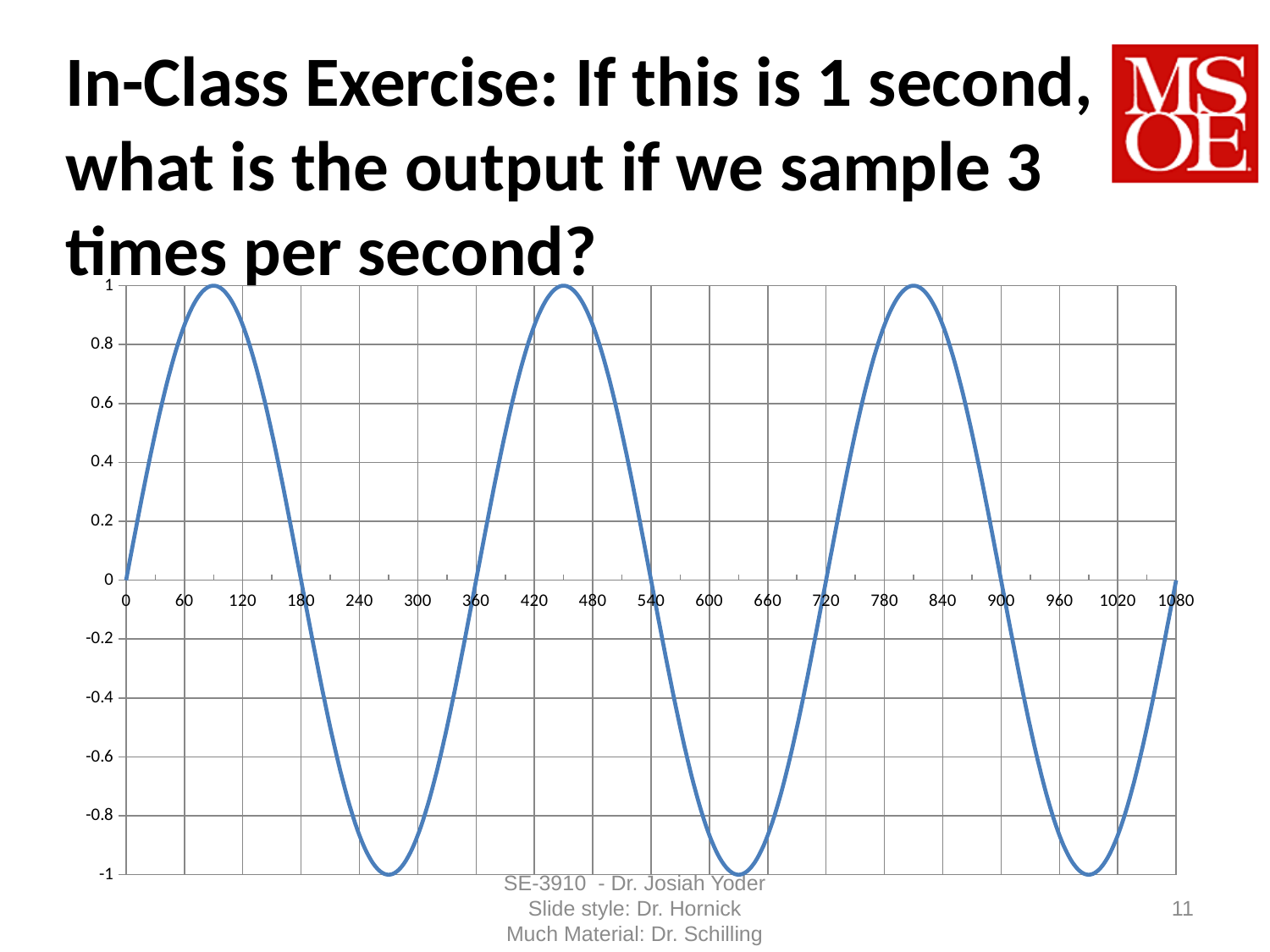
Which is larger, the value of the line at x = 120 or at x = 300? x = 120 Is the value of the line at x = 60 greater or less than 0.8? greater What is the highest value the line reaches? 1 What is the value of the line at x = 360? 0 Is the value of the line at x = 240 greater or less than -0.8? less How many peaks (maximum points) does the line reach across the chart? 3 What is the largest value labelled on the x axis? 1080 Between x = 0 and x = 60, does the line rise or fall? rise What is the value of the line at x = 720? 0 What is the value of the line at x = 0? 0 What kind of chart is shown on the slide? line chart What is the lowest value the line reaches? -1